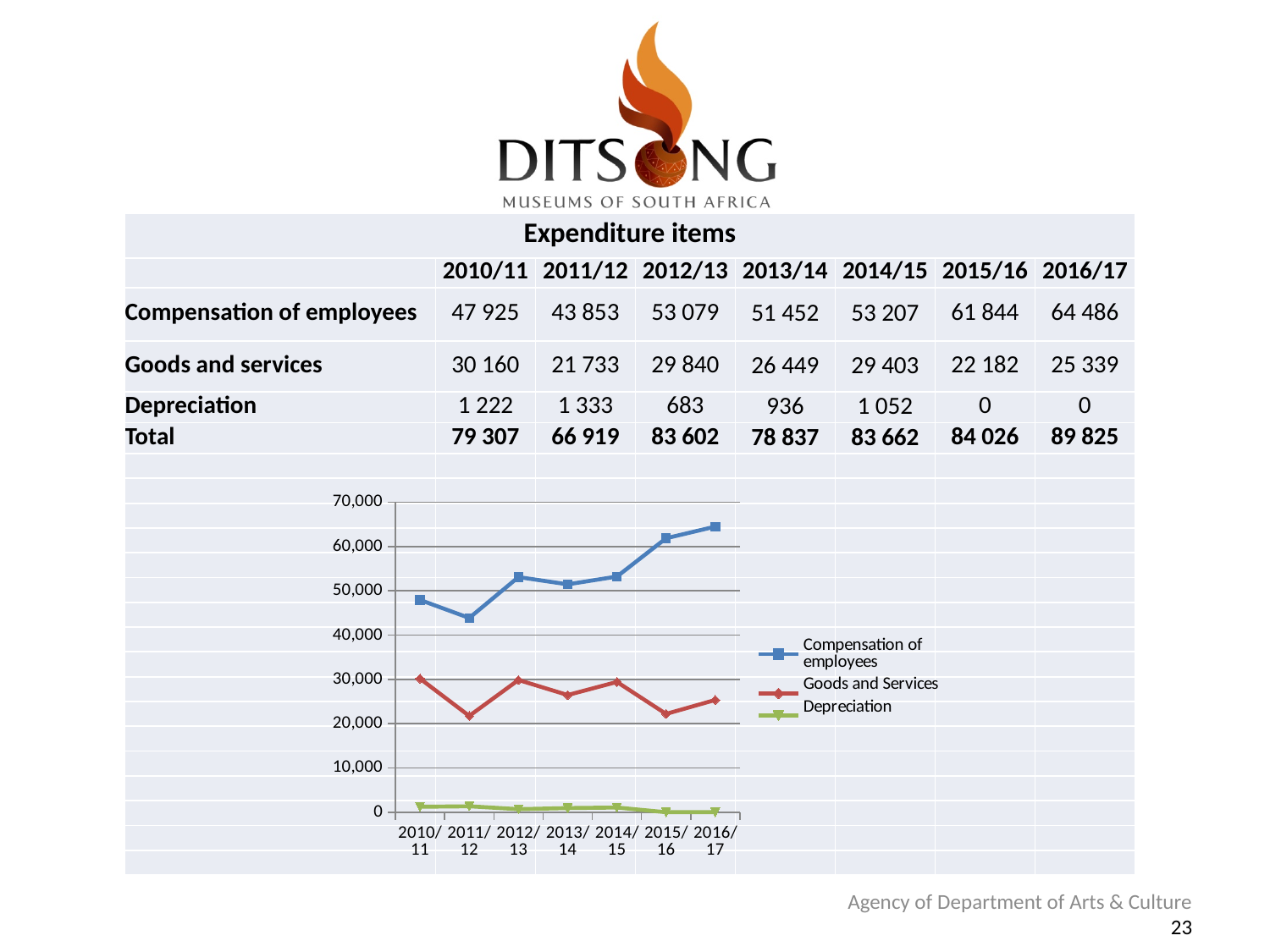
How many years are plotted along the x axis of the chart? 7 In which year was Compensation of employees highest? 2016/17 On the chart, is the Compensation of employees value for 2015/16 greater or less than 60,000? greater Which is larger in 2013/14: Compensation of employees or Goods and services? Compensation of employees In which year was Goods and services lowest? 2011/12 According to the table, what was the Total expenditure in 2014/15? 83 662 According to the table, what was Goods and services in 2011/12? 21 733 Does the Compensation of employees line generally rise or fall from 2011/12 to 2016/17? rise What is the difference between Compensation of employees in 2016/17 and 2010/11? 16 561 How many series does the chart legend list? 3 According to the table, what was Compensation of employees in 2016/17? 64 486 What kind of chart is shown on the slide? line chart